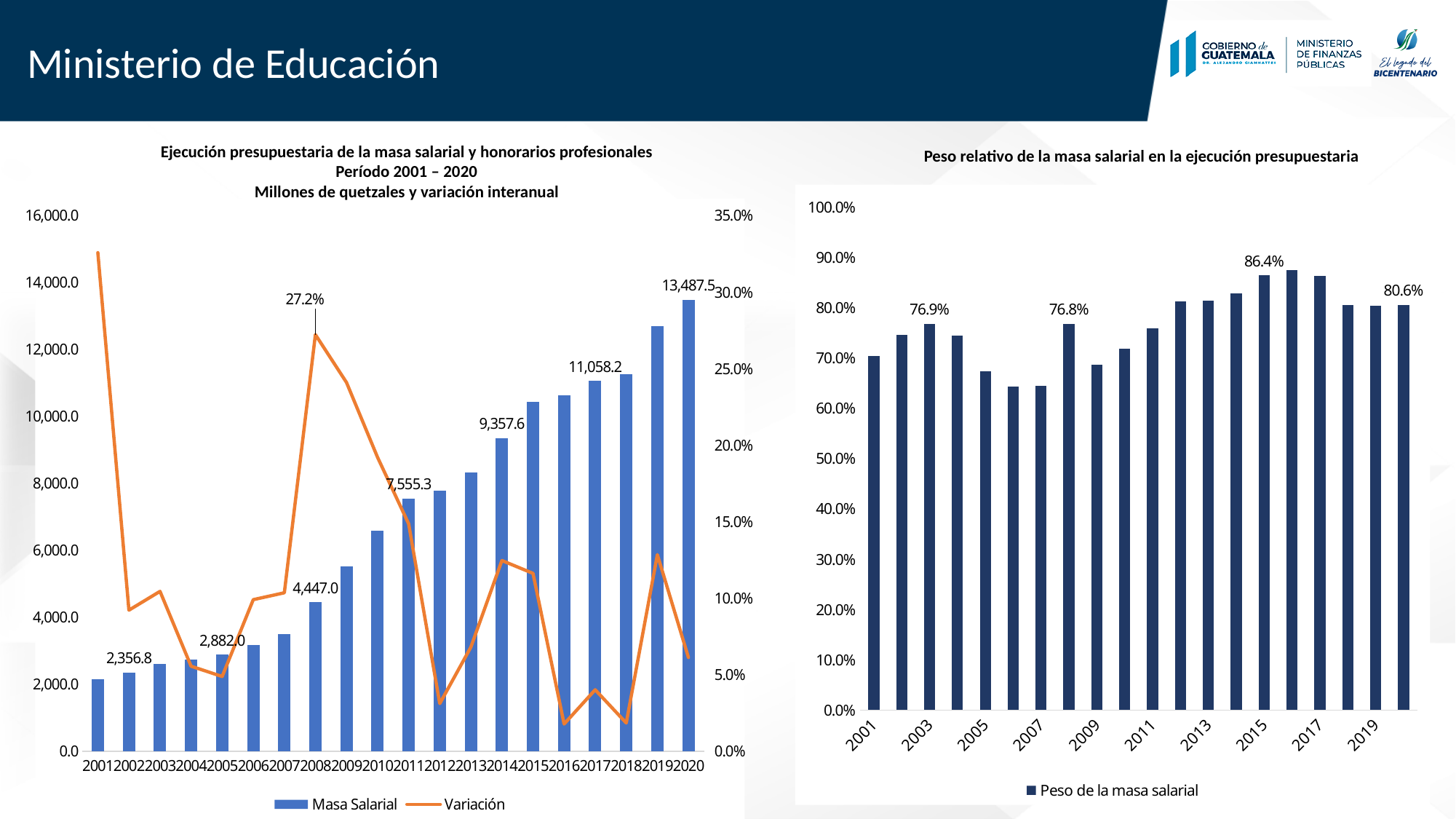
In the right chart (Peso relativo de la masa salarial), what is the value for 2015? 86.4% What kind of chart is the right chart (Peso relativo de la masa salarial)? bar chart In the left chart, is the Masa Salarial value for 2010 greater or less than 6,000.0? greater In the left chart, what is the Masa Salarial value for 2014? 9,357.6 In the right chart, which is larger: the value for 2015 or the value for 2020? 2015 In the left chart, do the Masa Salarial bars generally rise or fall from 2001 to 2020? rise In the left chart, what is the difference between the Masa Salarial values for 2020 and 2017? 2,429.3 In the left chart, which year has the highest Masa Salarial? 2020 In the left chart (Ejecución presupuestaria de la masa salarial), what is the Masa Salarial value for 2020? 13,487.5 In the left chart, how many series does the legend list? 2 In the right chart, is the value for 2006 greater or less than 70.0%? less In the left chart, what is the Variación value shown for 2008? 27.2%